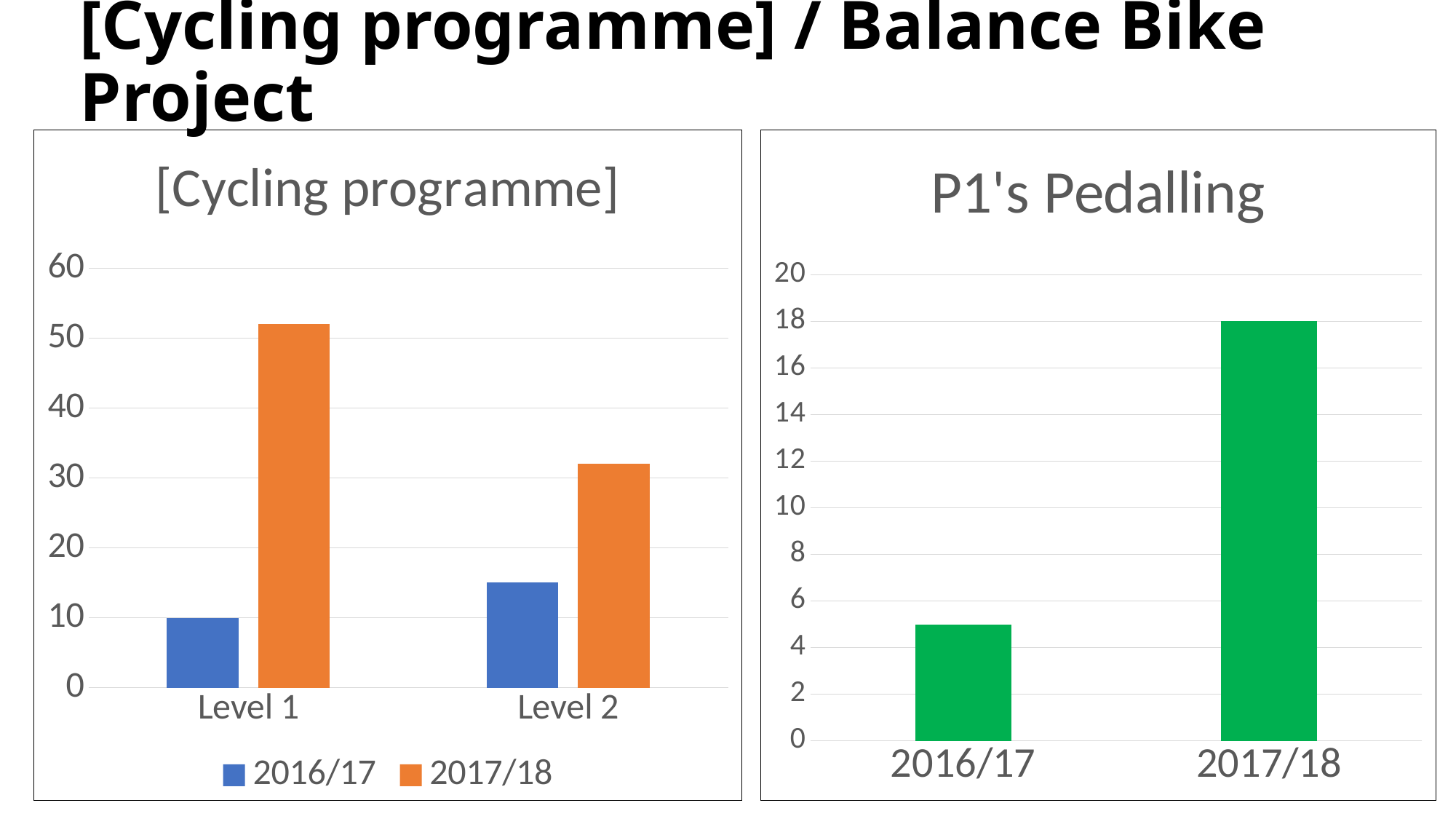
In the [Cycling programme] chart, which is larger at Level 2: 2016/17 or 2017/18? 2017/18 In the [Cycling programme] chart, which level has the highest 2017/18 value? Level 1 In the P1's Pedalling chart, is the value for 2016/17 greater or less than 4? greater In the [Cycling programme] chart, is the 2016/17 value for Level 2 greater or less than 20? less In the P1's Pedalling chart, what is the value for 2017/18? 18 In the [Cycling programme] chart, is the 2017/18 value for Level 2 greater or less than 30? greater In the P1's Pedalling chart, which year has the higher value? 2017/18 What kind of chart is the P1's Pedalling chart? bar chart In the [Cycling programme] chart, which level has the lowest 2016/17 value? Level 1 In the [Cycling programme] chart, what is the value for 2016/17 at Level 1? 10 How many series does the legend of the [Cycling programme] chart list? 2